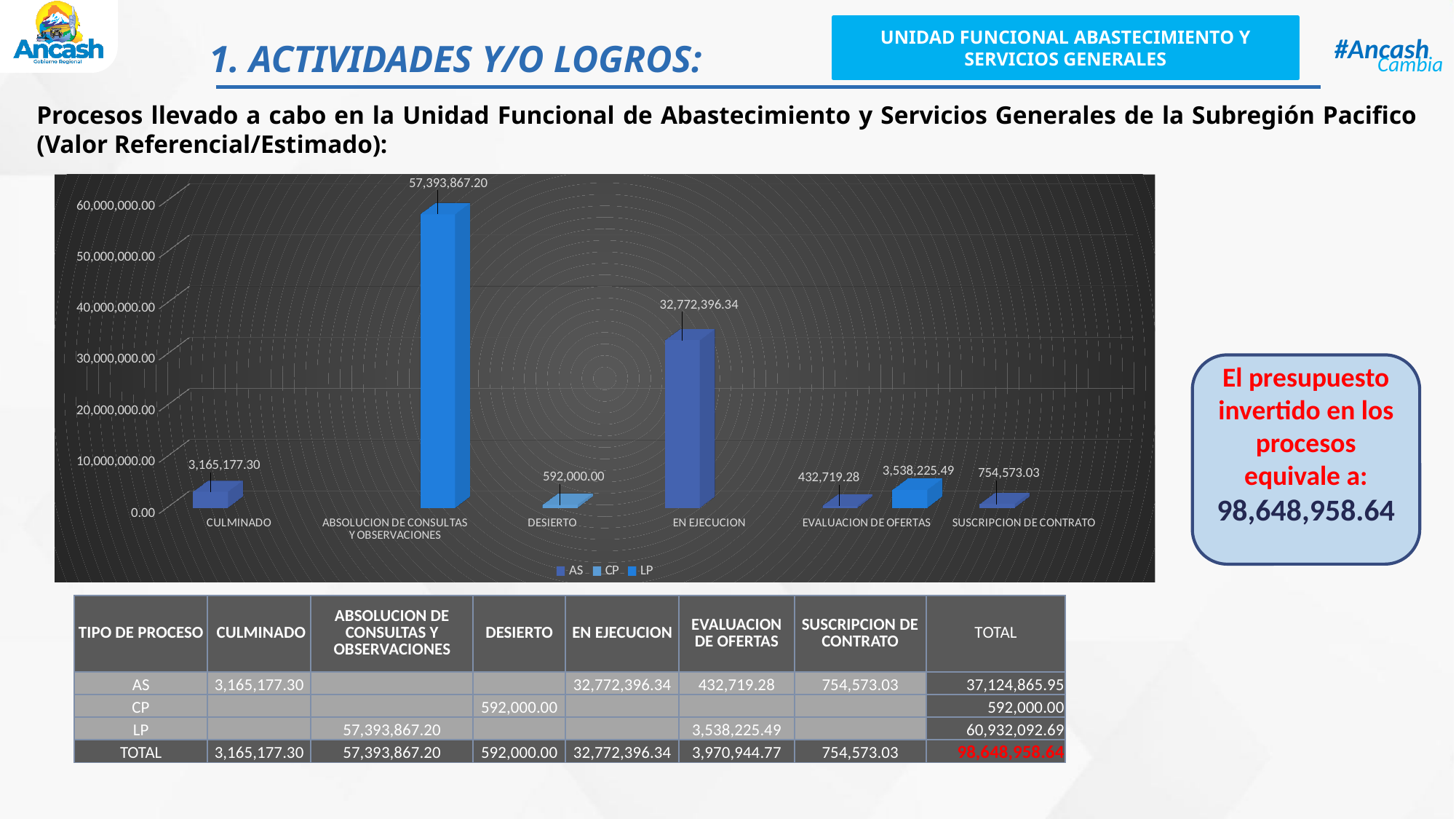
What is the value of the DESIERTO bar? 592,000.00 How many series does the chart legend list? 3 How many categories are shown on the x axis of the chart? 6 What kind of chart is shown on the slide? bar chart What is the value of the bar for ABSOLUCION DE CONSULTAS Y OBSERVACIONES? 57,393,867.20 Which category has the highest bar in the chart? ABSOLUCION DE CONSULTAS Y OBSERVACIONES What is the value of the CULMINADO bar? 3,165,177.30 What is the value of the SUSCRIPCION DE CONTRATO bar? 754,573.03 What is the difference between the ABSOLUCION DE CONSULTAS Y OBSERVACIONES bar and the EN EJECUCION bar? 24,621,470.86 What is the value of the EN EJECUCION bar? 32,772,396.34 Is the value for EN EJECUCION greater or less than 30,000,000.00? greater Which is larger, the CULMINADO bar or the DESIERTO bar? CULMINADO